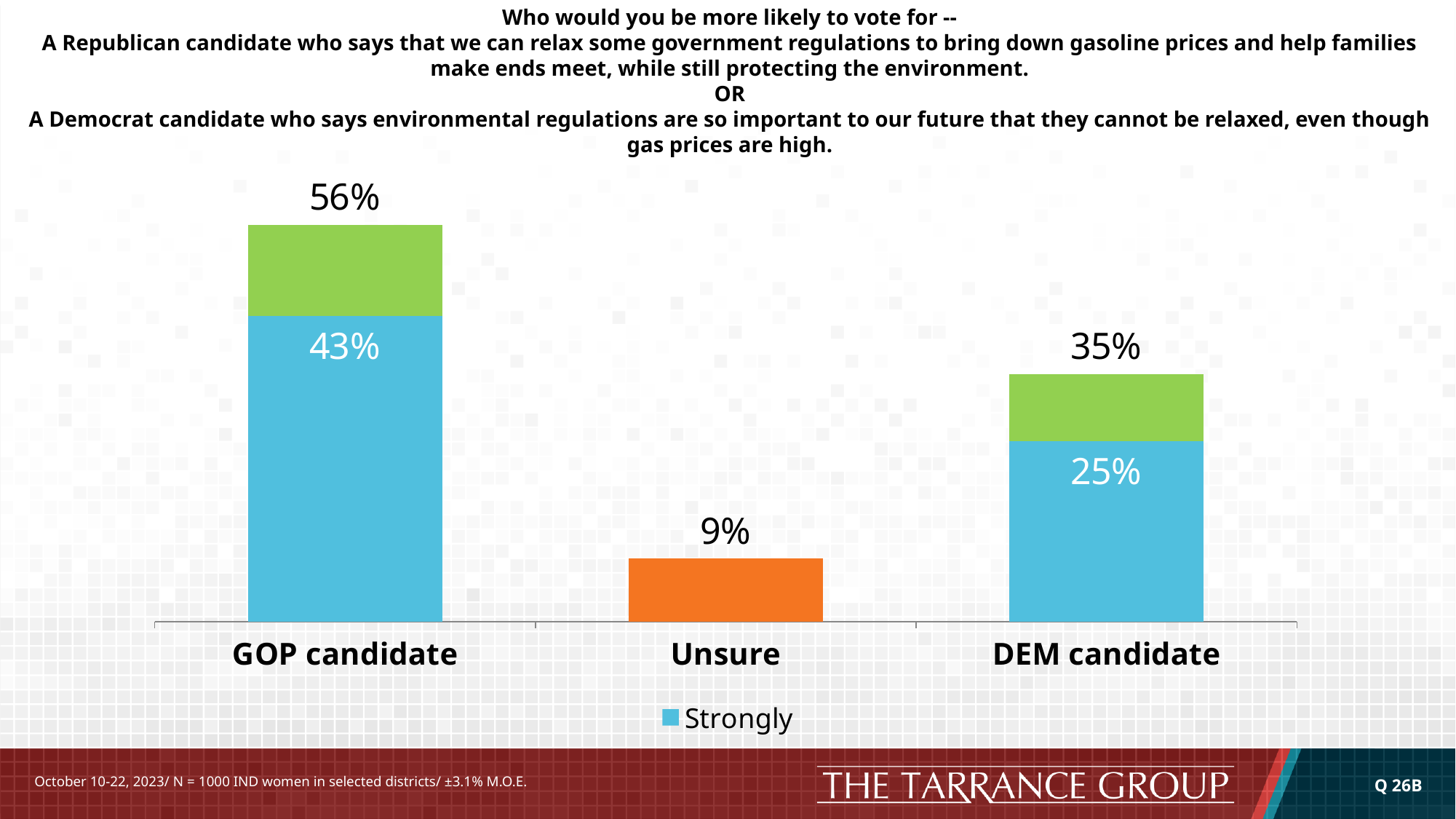
Which is larger, the 'Strongly' value for GOP candidate or the total for DEM candidate? GOP candidate 'Strongly' (43%) What is the difference between the 'Strongly' values for GOP candidate and DEM candidate? 18% How many categories are shown on the x axis? 3 What is the difference between the GOP candidate total and the DEM candidate total? 21% Which category has the lowest value? Unsure What is the total value shown for DEM candidate? 35% What is the 'Strongly' value for DEM candidate? 25% What is the 'Strongly' value for GOP candidate? 43% What is the total value shown for GOP candidate? 56% What is the value shown for Unsure? 9% Which category has the highest total value? GOP candidate What kind of chart is shown on the slide? Bar chart